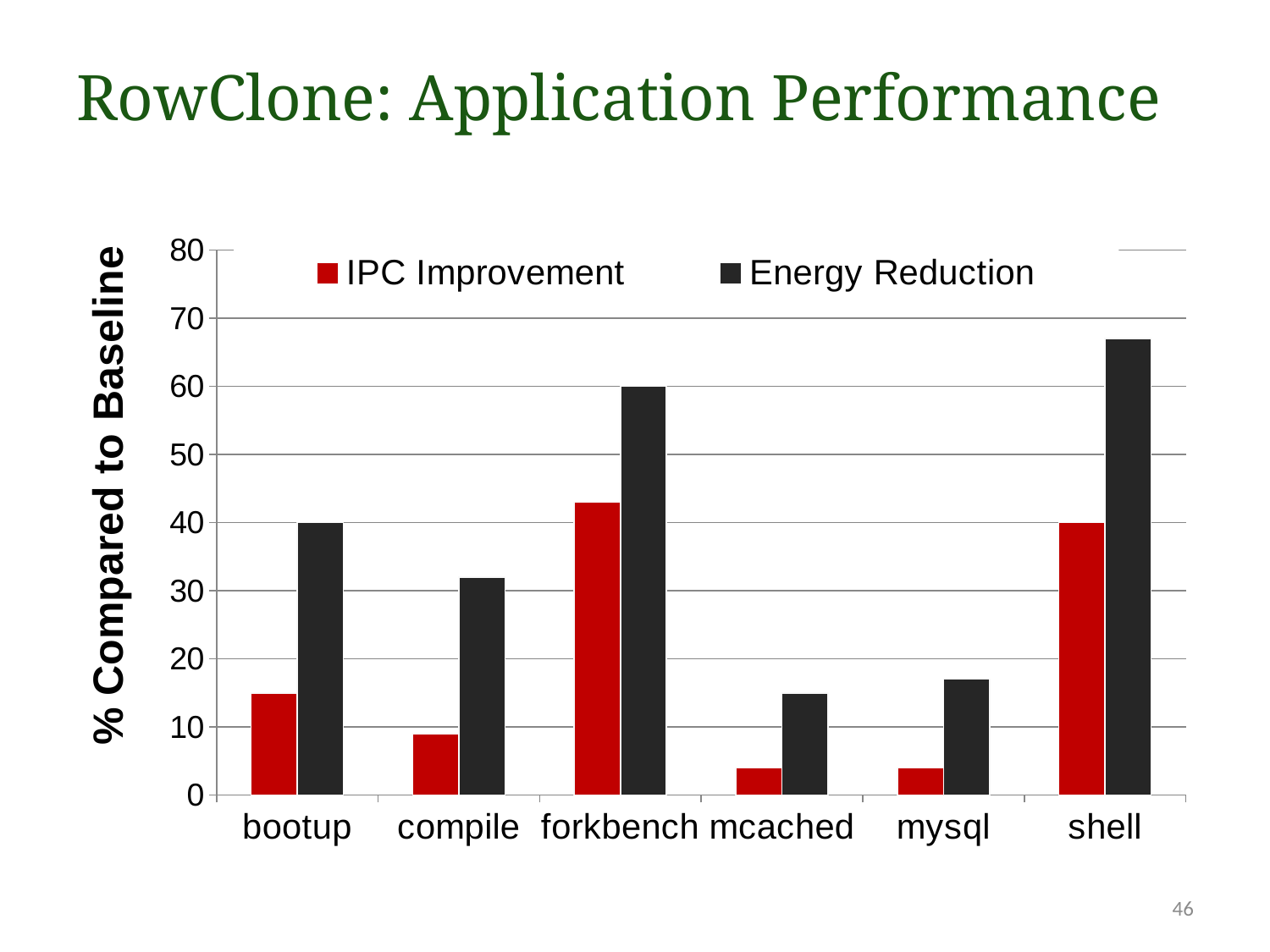
What kind of chart is shown on the slide? bar chart Is the IPC Improvement for forkbench greater or less than 40? greater Is the Energy Reduction for shell greater or less than 60? greater What is the Energy Reduction value for bootup? 40 Which is larger: the Energy Reduction for bootup or the Energy Reduction for compile? bootup How many application categories are shown on the x axis? 6 What is the title of the y axis? % Compared to Baseline Is the Energy Reduction for compile greater or less than 30? greater How many series does the legend list? 2 Which application has the highest IPC Improvement? forkbench Which application has the highest Energy Reduction? shell